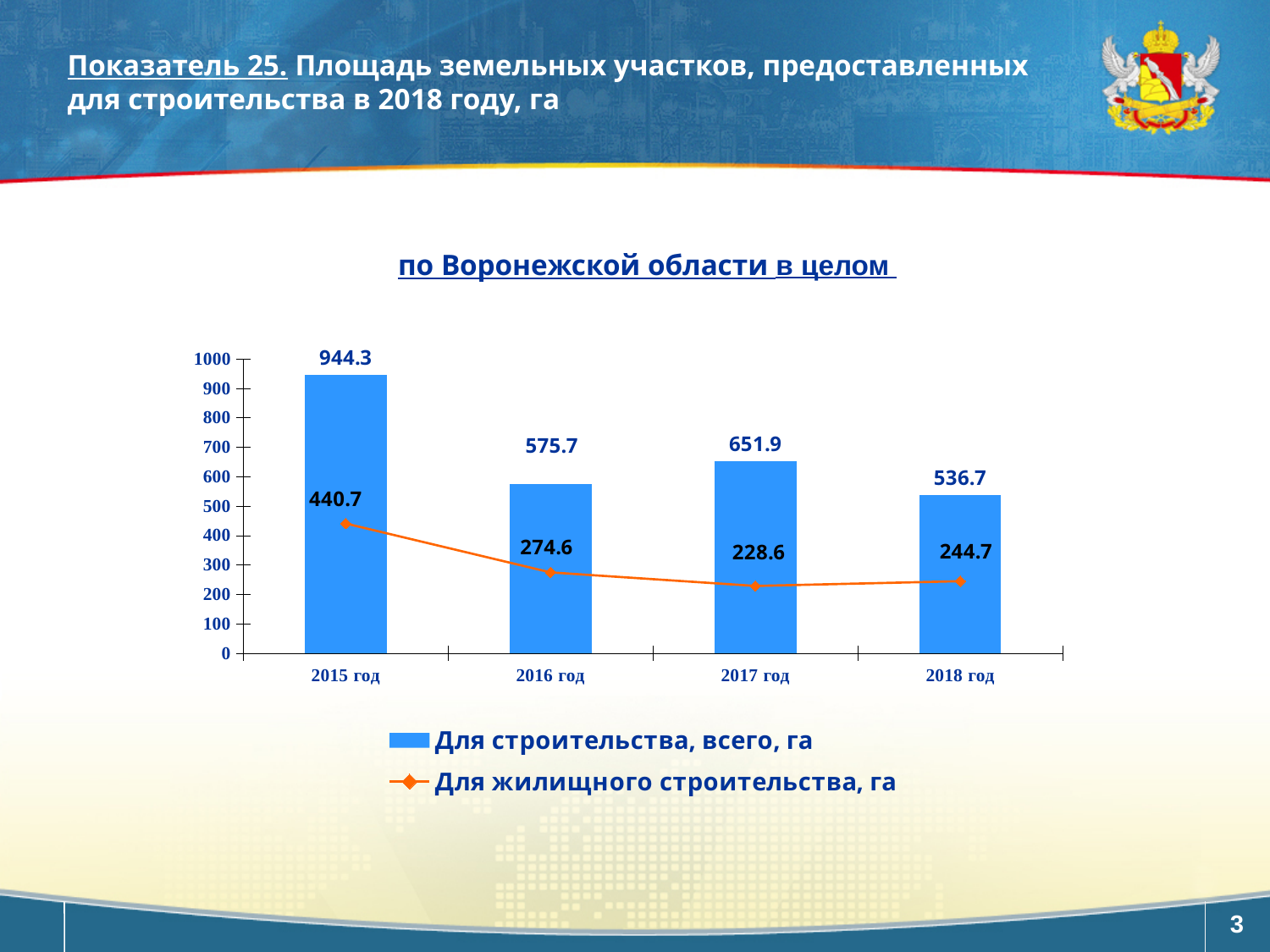
How many series does the legend list? 2 Which is larger: "Для строительства, всего, га" in 2017 год or in 2018 год? 2017 год What kind of chart is used for the series "Для строительства, всего, га"? bar chart How many years are shown on the x axis? 4 Which year has the lowest value for "Для жилищного строительства, га"? 2017 год What is the title shown above the chart? по Воронежской области в целом What is the value of "Для строительства, всего, га" for 2018 год? 536.7 What is the value of "Для строительства, всего, га" for 2015 год? 944.3 What is the value of "Для жилищного строительства, га" for 2017 год? 228.6 Is the value for "Для строительства, всего, га" in 2016 год greater or less than 500? greater What is the difference between "Для строительства, всего, га" in 2015 год and 2016 год? 368.6 Which year has the highest value for "Для строительства, всего, га"? 2015 год